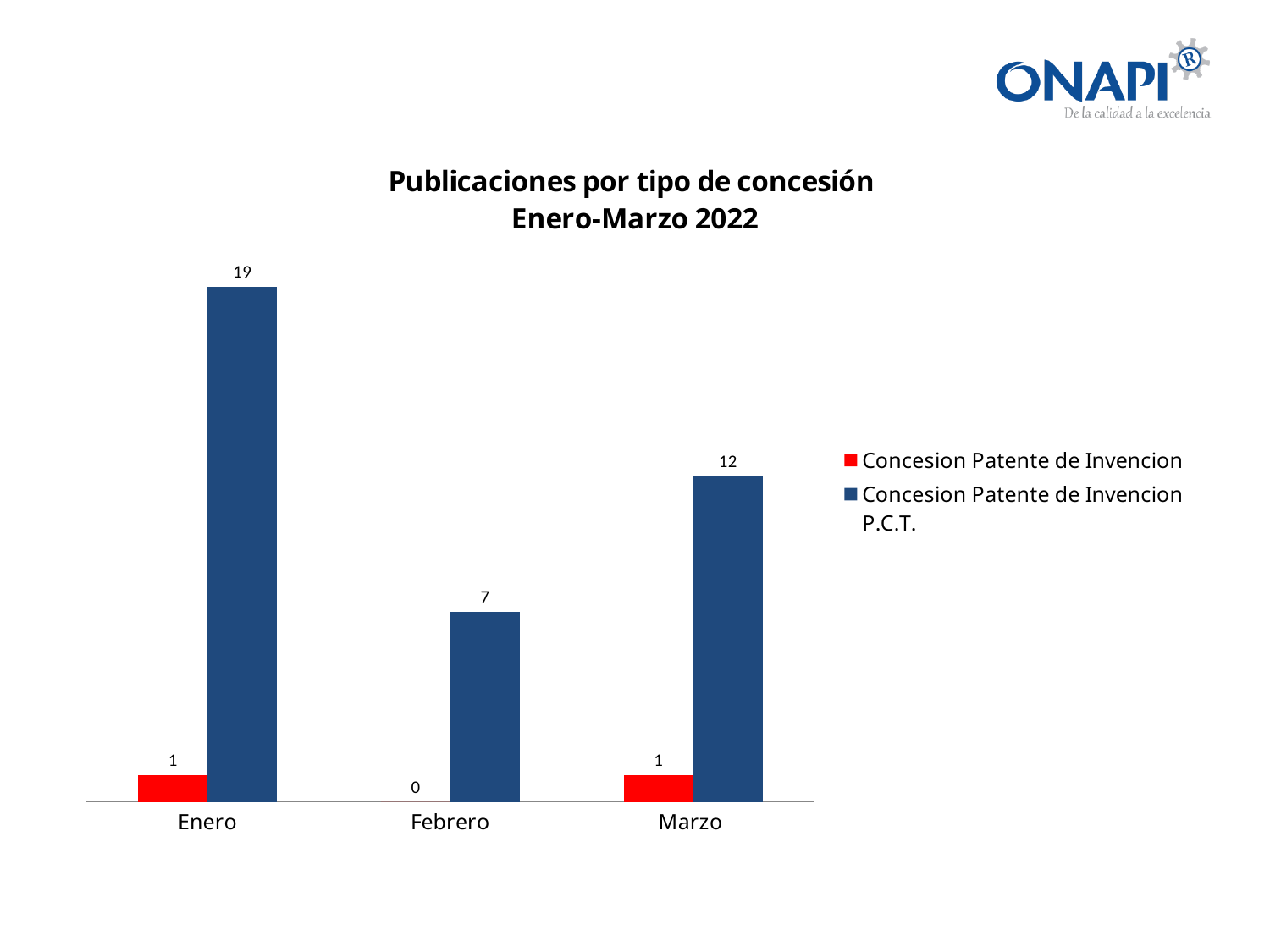
What kind of chart is shown on the slide? Bar chart What is the value for Concesion Patente de Invencion in Marzo? 1 What is the difference between the Concesion Patente de Invencion P.C.T. values for Enero and Marzo? 7 What is the title of the chart? Publicaciones por tipo de concesión Enero-Marzo 2022 Which month has the highest value for Concesion Patente de Invencion P.C.T.? Enero What is the value for Concesion Patente de Invencion P.C.T. in Marzo? 12 Which month has the lowest value for Concesion Patente de Invencion P.C.T.? Febrero How many months are shown on the x axis? 3 Which is larger: the Concesion Patente de Invencion P.C.T. value for Febrero or for Marzo? Marzo What is the value for Concesion Patente de Invencion P.C.T. in Enero? 19 What is the value for Concesion Patente de Invencion in Febrero? 0 How many series does the legend list? 2